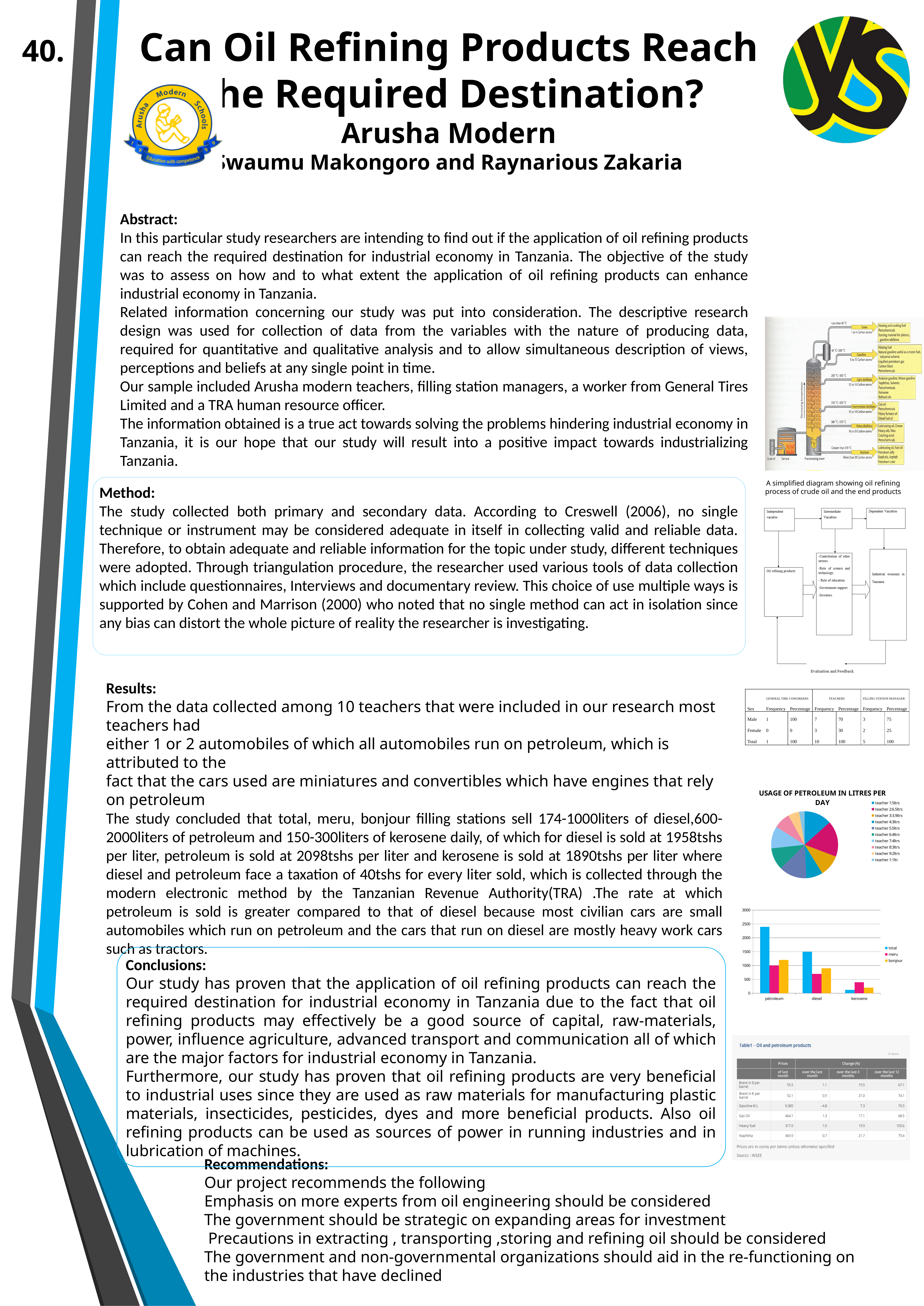
What kind of chart is the chart at the bottom right with categories petroleum, diesel and kerosene? bar chart In the bar chart with categories petroleum, diesel and kerosene, how many categories are shown on the x axis? 3 In the bar chart with categories petroleum, diesel and kerosene, is the 'total' value for diesel greater or less than 2000? less In the bar chart with categories petroleum, diesel and kerosene, is the 'total' value for petroleum greater or less than 2000? greater In the bar chart with categories petroleum, diesel and kerosene, which category has the highest 'total' bar? petroleum In the bar chart with categories petroleum, diesel and kerosene, which category has the lowest 'total' bar? kerosene In the bar chart with categories petroleum, diesel and kerosene, which is larger for petroleum: the 'total' bar or the 'meru' bar? total In the bar chart with categories petroleum, diesel and kerosene, do the 'total' values rise or fall from petroleum to kerosene along the x axis? fall What kind of chart is the chart titled 'USAGE OF PETROLEUM IN LITRES PER DAY'? pie chart In the bar chart with categories petroleum, diesel and kerosene, how many series does the legend list? 3 In the bar chart with categories petroleum, diesel and kerosene, is the 'meru' value for kerosene greater or less than 1000? less What is the title of the pie chart on the right side of the slide? USAGE OF PETROLEUM IN LITRES PER DAY